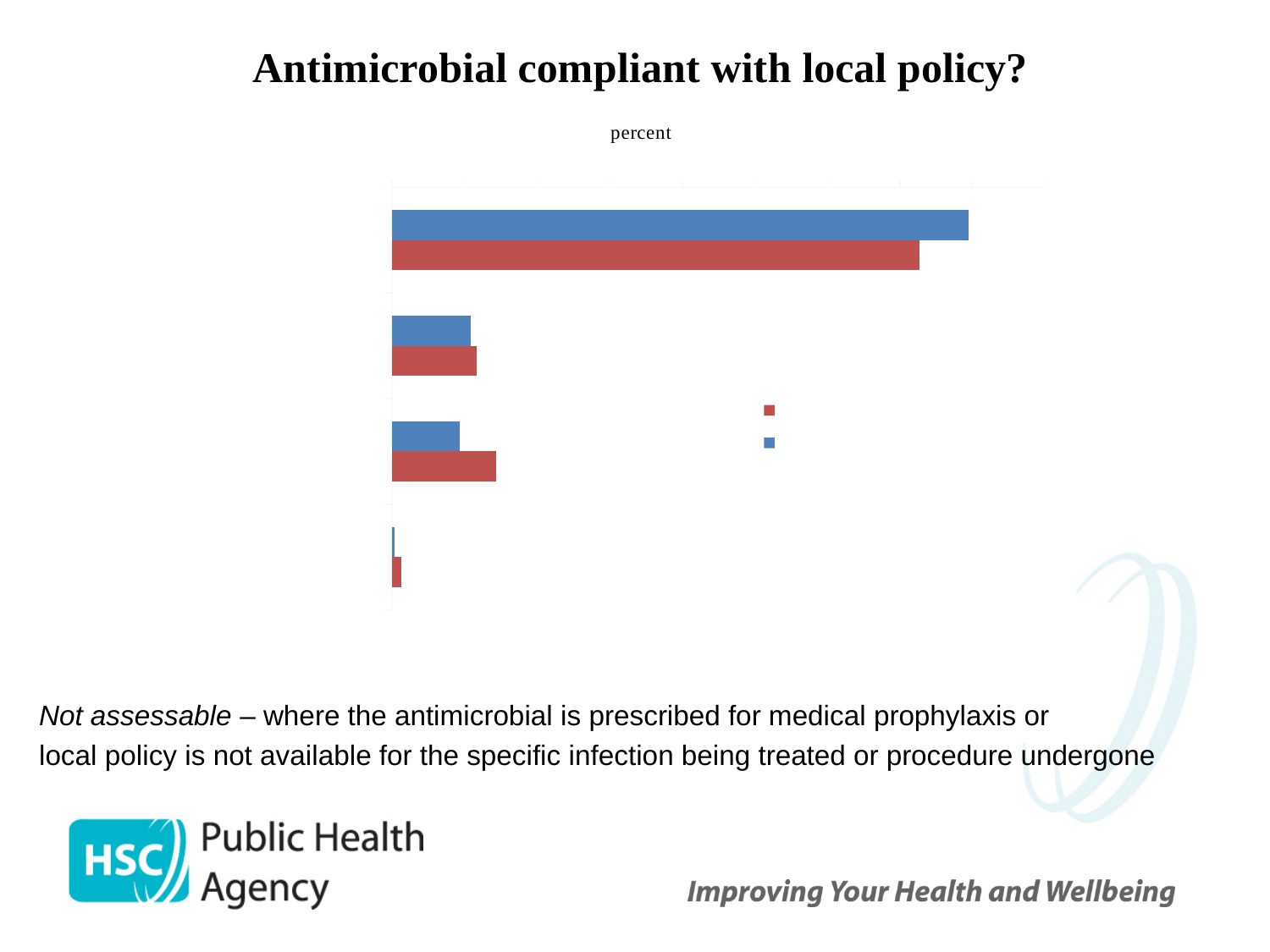
How many series does the legend of the chart show? 2 In the third group of bars from the top, which series has the longer bar, the blue one or the red one? red How many category groups of bars are plotted in the chart? 4 What is the axis title shown above the chart? percent In the top group of bars, which series has the longer bar, the blue one or the red one? blue What is the title of the chart on the slide? Antimicrobial compliant with local policy? Which group of bars, counting from the top, has the shortest bars in the chart? the fourth (bottom) group Which group of bars, counting from the top, has the longest bars in the chart? the first (top) group What kind of chart is shown on the slide? bar chart